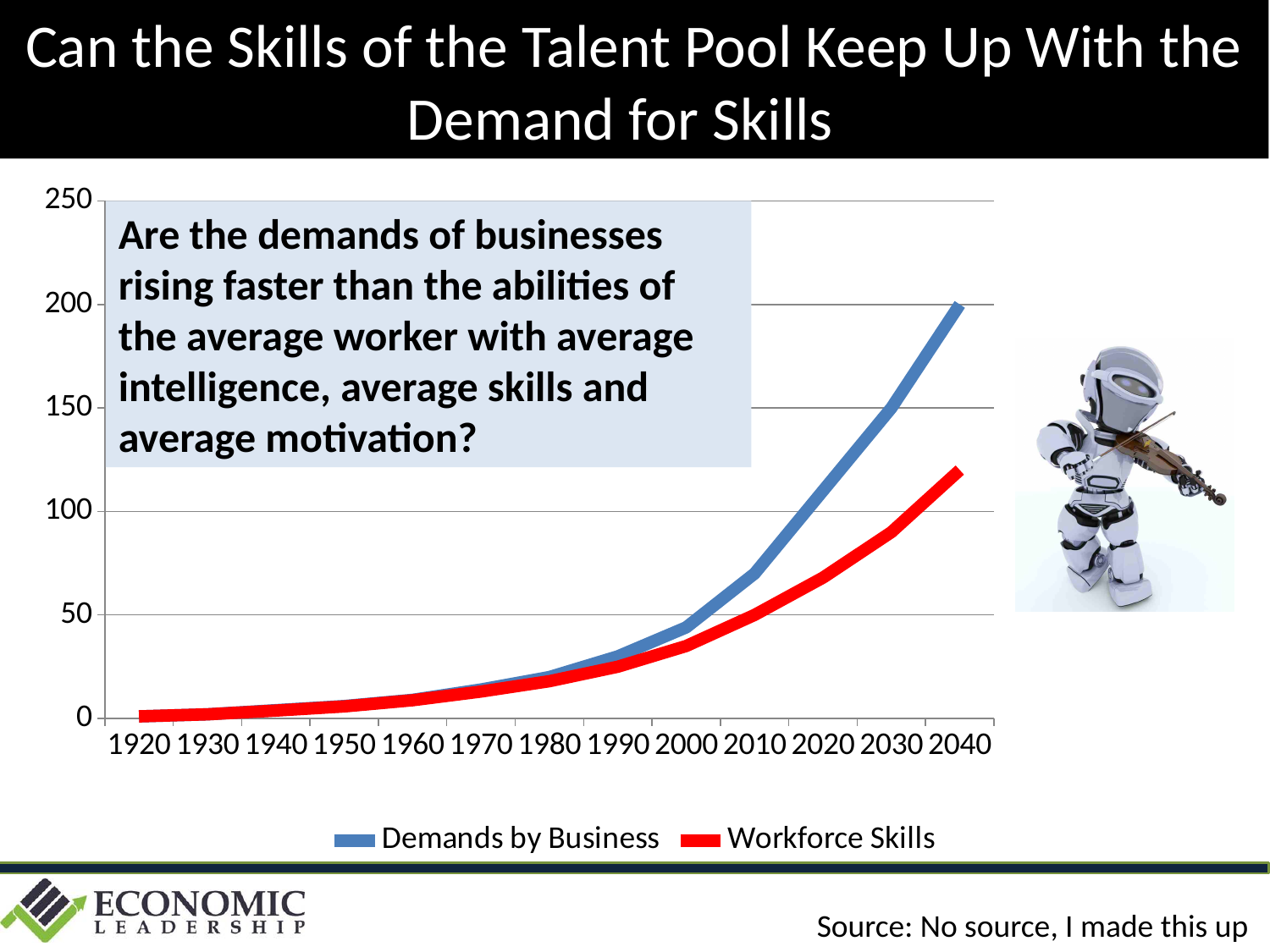
What kind of chart is shown on the slide? line chart In 2040, which series is higher: Demands by Business or Workforce Skills? Demands by Business In which year does Demands by Business reach its highest value? 2040 Do the values for Demands by Business rise or fall from 1920 to 2040? rise What colour is the Workforce Skills line? red How many series does the legend list? 2 Is the value for Workforce Skills in 2040 greater or less than 100? greater How many years are labelled along the x axis? 13 Is the value for Demands by Business in 2040 greater or less than 150? greater Is the value for Demands by Business in 2010 greater or less than 50? greater